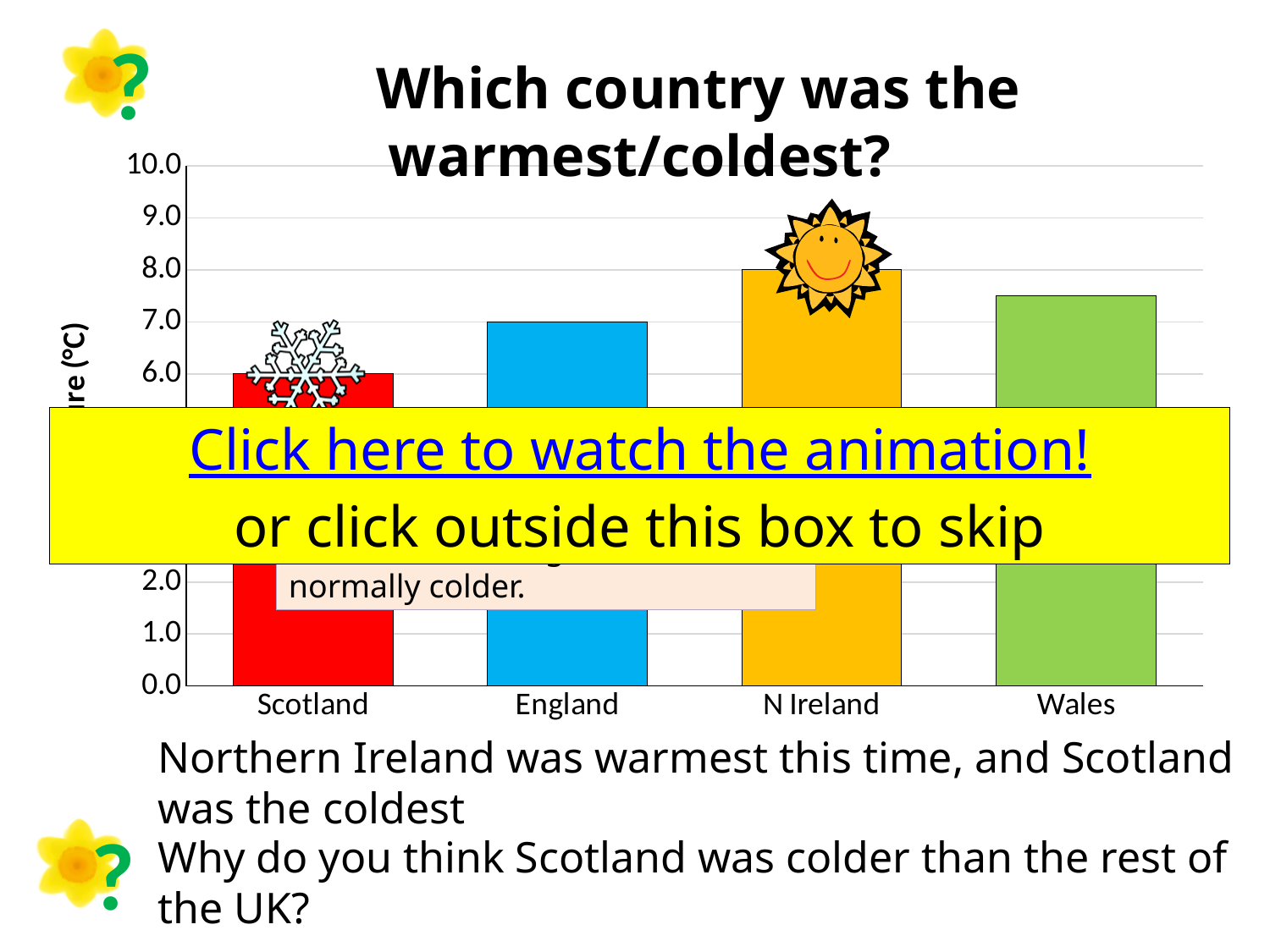
Is the value for Wales greater or less than 7.0? greater What is the value for England in the chart? 7.0 How many countries are shown on the x axis of the chart? 4 Which country has the lowest bar in the chart? Scotland What colour is the bar for Scotland? red What is the value for N Ireland in the chart? 8.0 Is the value for Wales greater or less than 8.0? less Which has the larger value, England or Wales? Wales What is the value for Scotland in the chart? 6.0 Which country has the highest bar in the chart? N Ireland What kind of chart is shown on the slide? bar chart What is the difference between the values for N Ireland and Scotland? 2.0